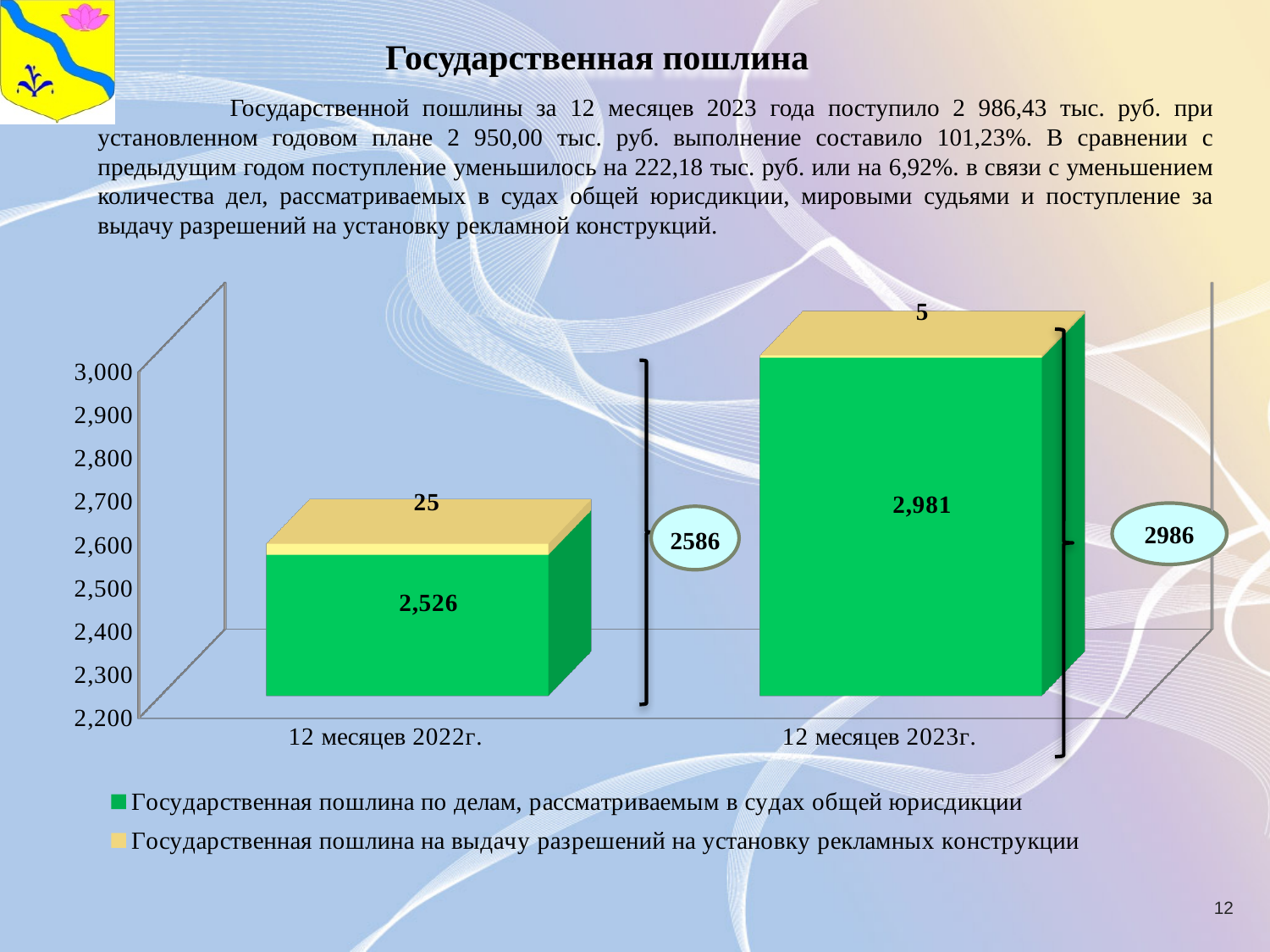
Which period has the larger value for 'Государственная пошлина по делам, рассматриваемым в судах общей юрисдикции'? 12 месяцев 2023г. What is the total of the stacked bar for '12 месяцев 2023г.'? 2986 What is the difference between the 2022 and 2023 values for 'Государственная пошлина на выдачу разрешений на установку рекламных конструкции'? 20 What kind of chart is shown on the slide? bar chart What is the value of the series 'Государственная пошлина на выдачу разрешений на установку рекламных конструкции' for '12 месяцев 2022г.'? 25 What is the value of the series 'Государственная пошлина по делам, рассматриваемым в судах общей юрисдикции' for '12 месяцев 2023г.'? 2,981 By how much did the value for 'Государственная пошлина по делам, рассматриваемым в судах общей юрисдикции' change from '12 месяцев 2022г.' to '12 месяцев 2023г.'? 455 Which colour represents 'Государственная пошлина по делам, рассматриваемым в судах общей юрисдикции' in the chart? green What is the value of the series 'Государственная пошлина на выдачу разрешений на установку рекламных конструкции' for '12 месяцев 2023г.'? 5 How many categories are shown on the x axis of the chart? 2 What is the value of the series 'Государственная пошлина по делам, рассматриваемым в судах общей юрисдикции' for '12 месяцев 2022г.'? 2,526 How many series does the chart legend list? 2